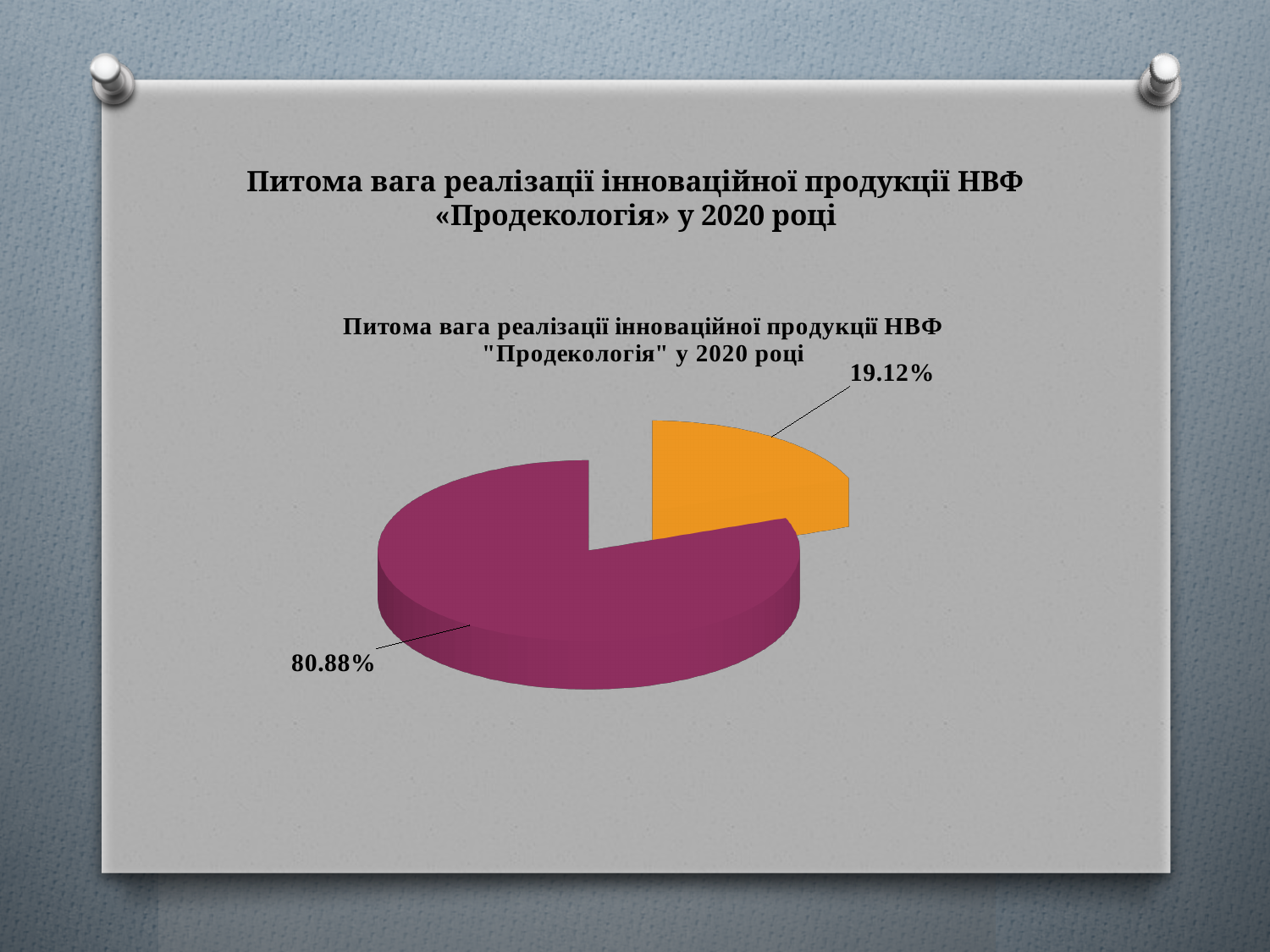
What is the total of the two slice values shown on the pie chart? 100% What is the value shown for the orange slice of the pie chart? 19.12% Which is larger, the orange slice or the magenta slice? the magenta slice What is the difference between the two slice values in the pie chart? 61.76% What kind of chart is shown on the slide? pie chart Which slice of the pie chart is the largest? the magenta slice (80.88%) How many slices does the pie chart have? 2 Which slice of the pie chart is the smallest? the orange slice (19.12%) What is the value shown for the magenta slice of the pie chart? 80.88% What is the title of the chart? Питома вага реалізації інноваційної продукції НВФ "Продекологія" у 2020 році What share of the pie does the orange slice represent? 19.12% Which year does the chart title refer to? 2020